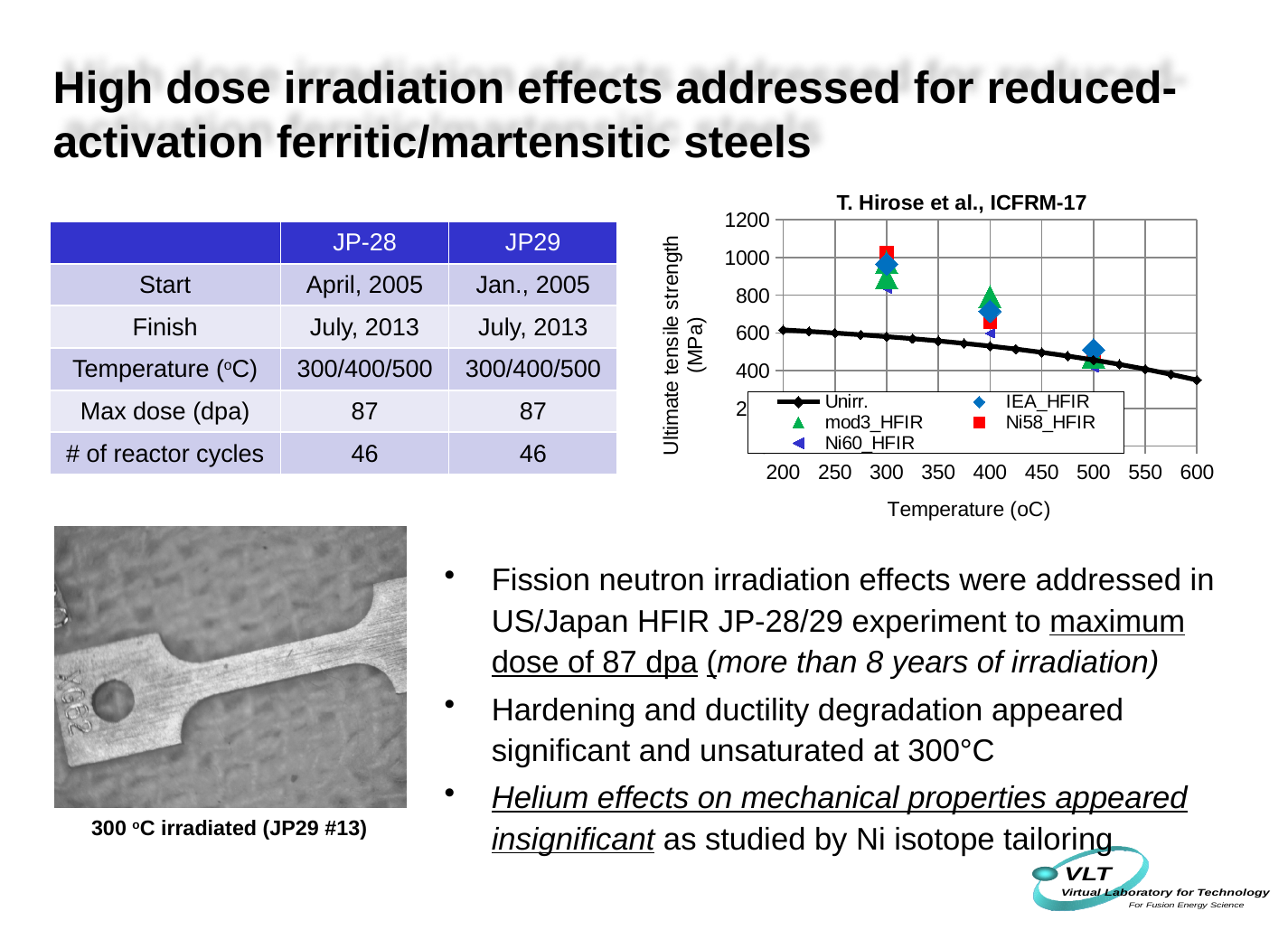
For the IEA_HFIR series, which temperature has the higher value: 300 oC or 500 oC? 300 oC What is the label of the y axis of the chart? Ultimate tensile strength (MPa) How many series does the chart legend list? 5 Is the value of the Ni58_HFIR series at 300 oC greater or less than 800? greater Does the Unirr. series rise or fall as temperature increases along the x axis? fall What kind of chart is shown on the slide? scatter chart Is the value of the Unirr. series at 200 oC greater or less than 800? less At how many temperatures are the irradiated (HFIR) series plotted? 3 Is the value of the IEA_HFIR series at 500 oC greater or less than 600? less At 300 oC, which is larger: the Ni58_HFIR value or the Unirr. value? Ni58_HFIR What is the title of the chart on the slide? T. Hirose et al., ICFRM-17